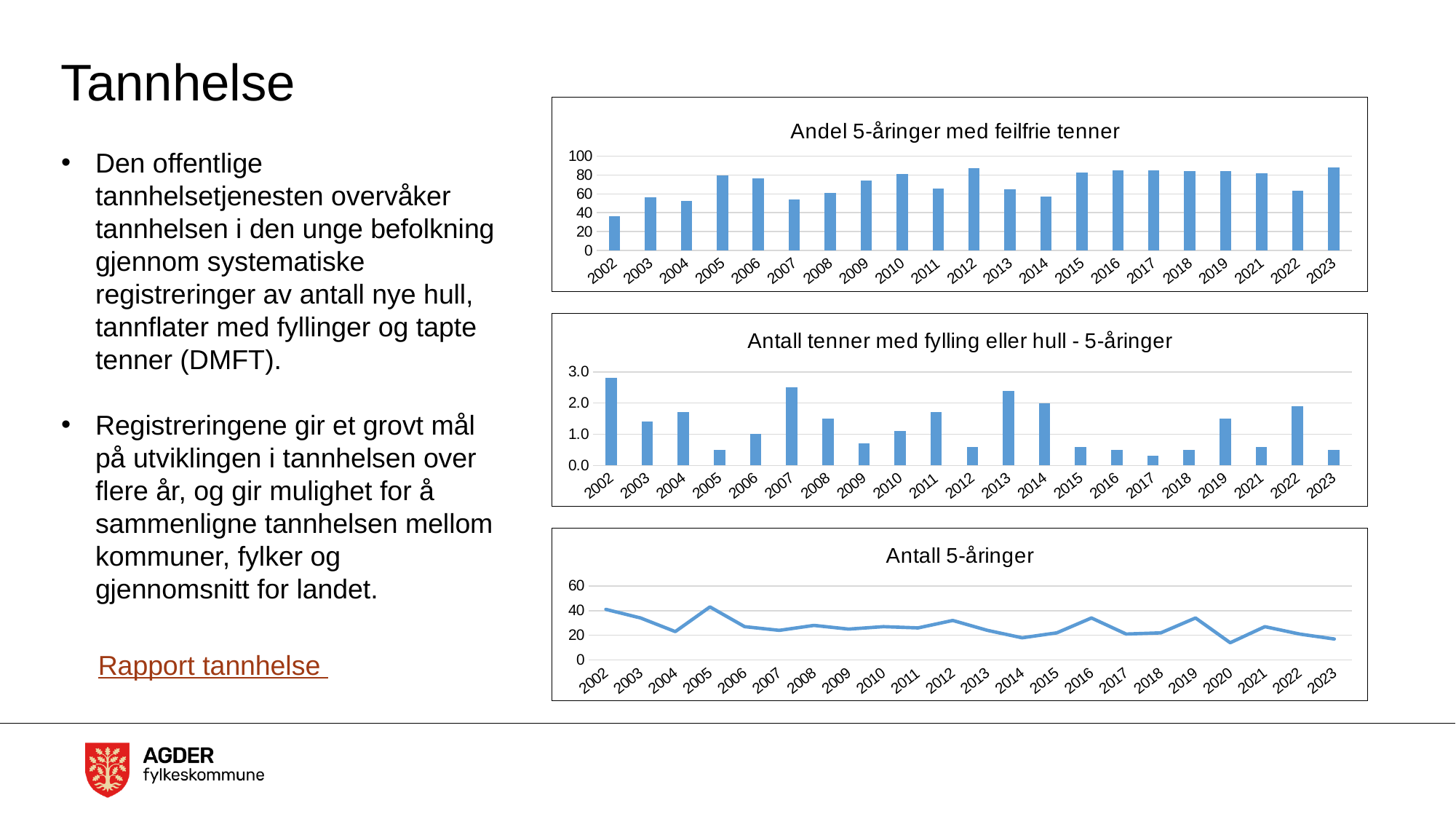
How many years are shown on the x axis of the top chart 'Andel 5-åringer med feilfrie tenner'? 21 In the top chart 'Andel 5-åringer med feilfrie tenner', which is larger, the value for 2002 or the value for 2005? 2005 In the middle chart 'Antall tenner med fylling eller hull - 5-åringer', is the value for 2013 greater or less than 2.0? greater In the top chart 'Andel 5-åringer med feilfrie tenner', is the value for 2014 greater or less than 60? less In the middle chart 'Antall tenner med fylling eller hull - 5-åringer', which year has the highest value? 2002 What kind of chart is the bottom chart, 'Antall 5-åringer'? line chart In the bottom chart 'Antall 5-åringer', is the value for 2020 greater or less than 20? less In the middle chart 'Antall tenner med fylling eller hull - 5-åringer', which year has the lowest value? 2017 What kind of chart is the top chart, 'Andel 5-åringer med feilfrie tenner'? bar chart In the top chart 'Andel 5-åringer med feilfrie tenner', which year has the lowest value? 2002 How many years are shown on the x axis of the bottom chart 'Antall 5-åringer'? 22